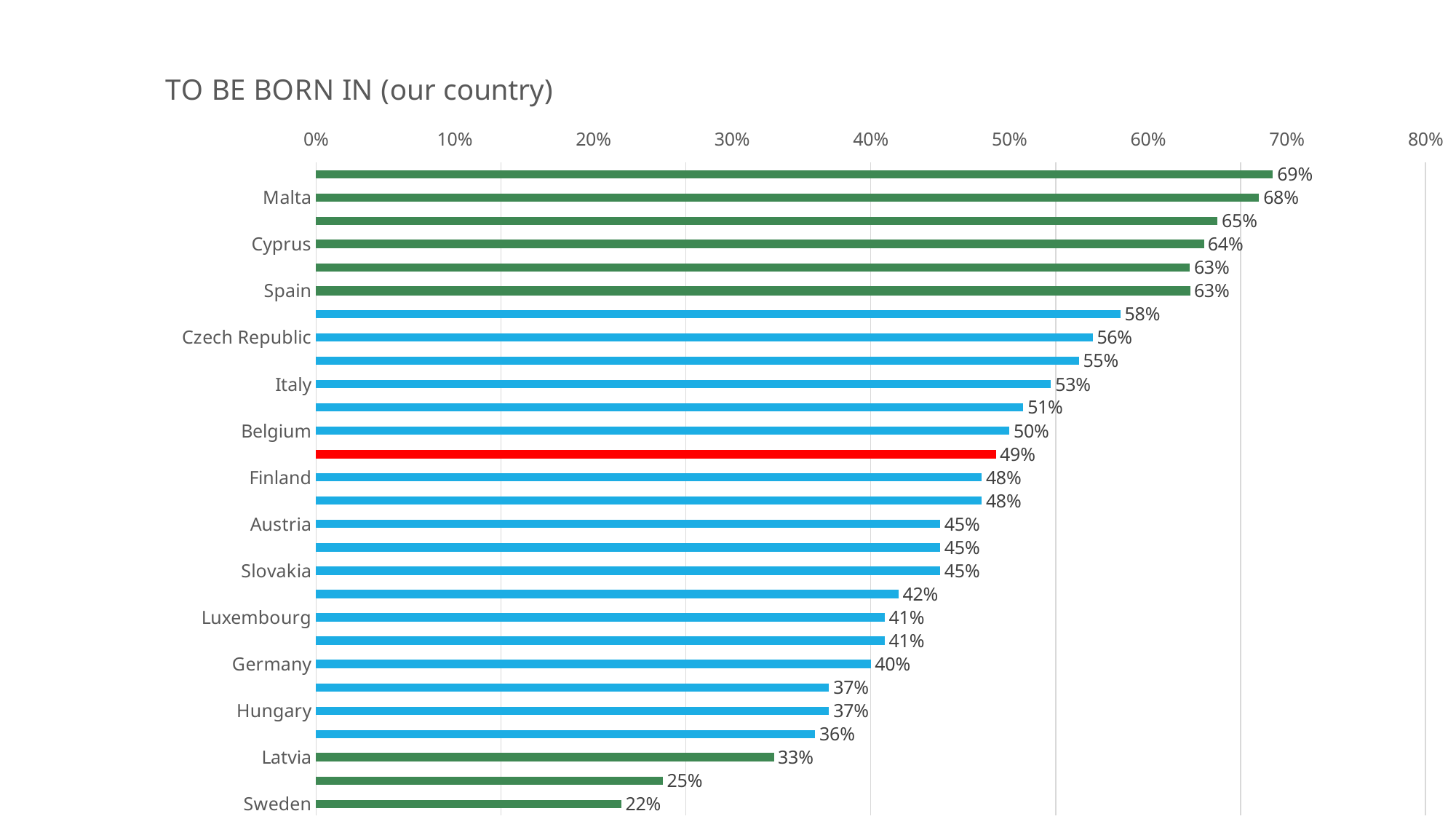
What is the value for Germany? 40% Which labelled country has the lowest value? Sweden How many bars are plotted on the chart? 28 What is the highest value shown on the chart? 69% Is the value for Hungary greater or less than 40%? less What is the value for Malta? 68% What is the value for Sweden? 22% What is the value for Italy? 53% What is the value for Cyprus? 64% Which is larger, the value for Belgium or the value for Finland? Belgium What is the difference between the values for Malta and Cyprus? 4% What kind of chart is shown? bar chart